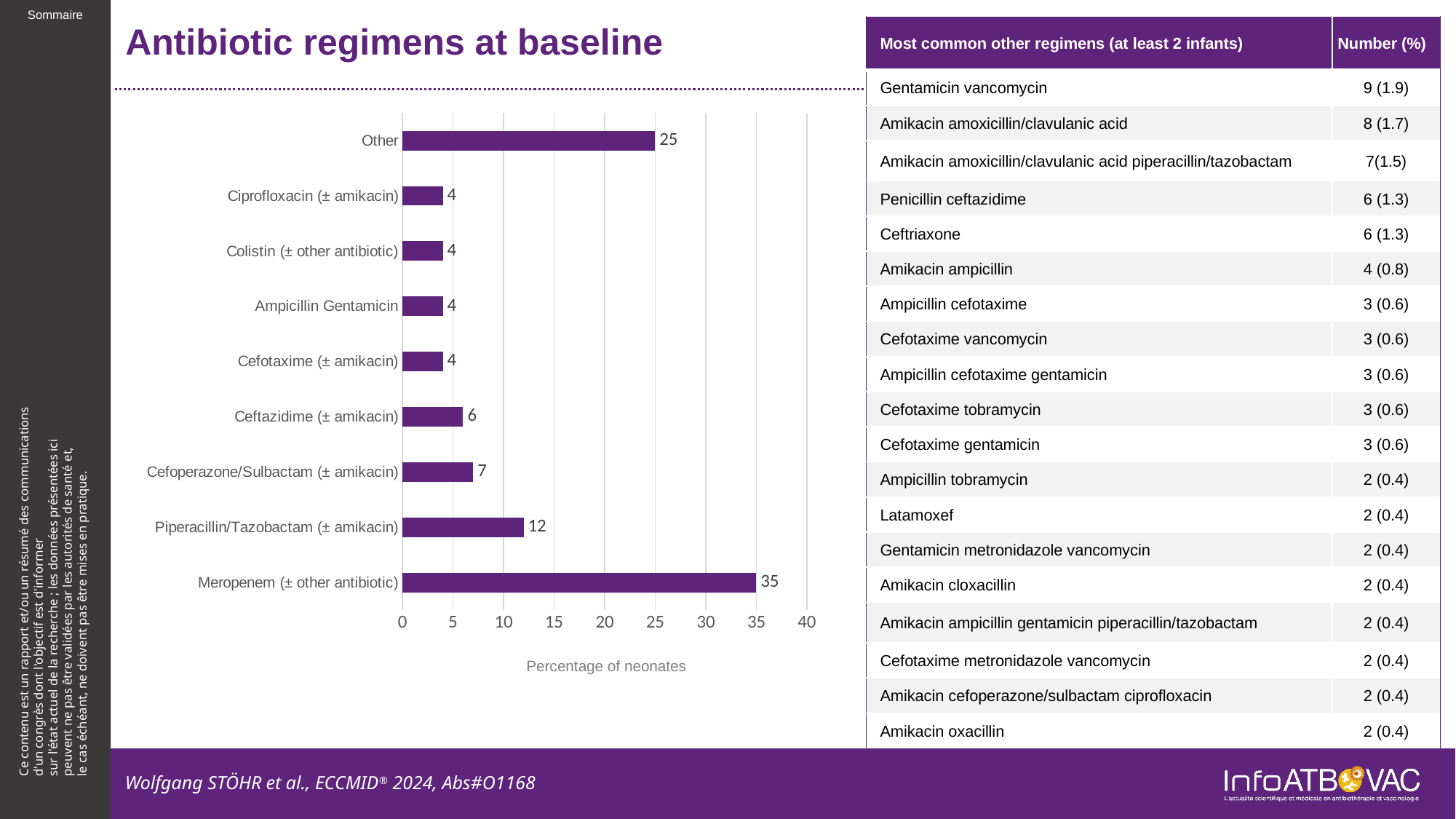
What is the difference in percentage of neonates between Piperacillin/Tazobactam (± amikacin) and Ceftazidime (± amikacin)? 6 What is the percentage of neonates for Piperacillin/Tazobactam (± amikacin)? 12 Is the value for Piperacillin/Tazobactam (± amikacin) greater or less than 10? greater What kind of chart is used to show the antibiotic regimens at baseline? bar chart What is the label of the x axis of the bar chart? Percentage of neonates What is the difference in percentage of neonates between Meropenem (± other antibiotic) and Other? 10 What is the percentage of neonates for the Other category? 25 What is the percentage of neonates for Meropenem (± other antibiotic)? 35 Which has a higher percentage of neonates, Cefoperazone/Sulbactam (± amikacin) or Ceftazidime (± amikacin)? Cefoperazone/Sulbactam (± amikacin) Which antibiotic regimen has the highest percentage of neonates? Meropenem (± other antibiotic) What is the percentage of neonates for Cefoperazone/Sulbactam (± amikacin)? 7 How many antibiotic regimen categories are shown in the bar chart? 9